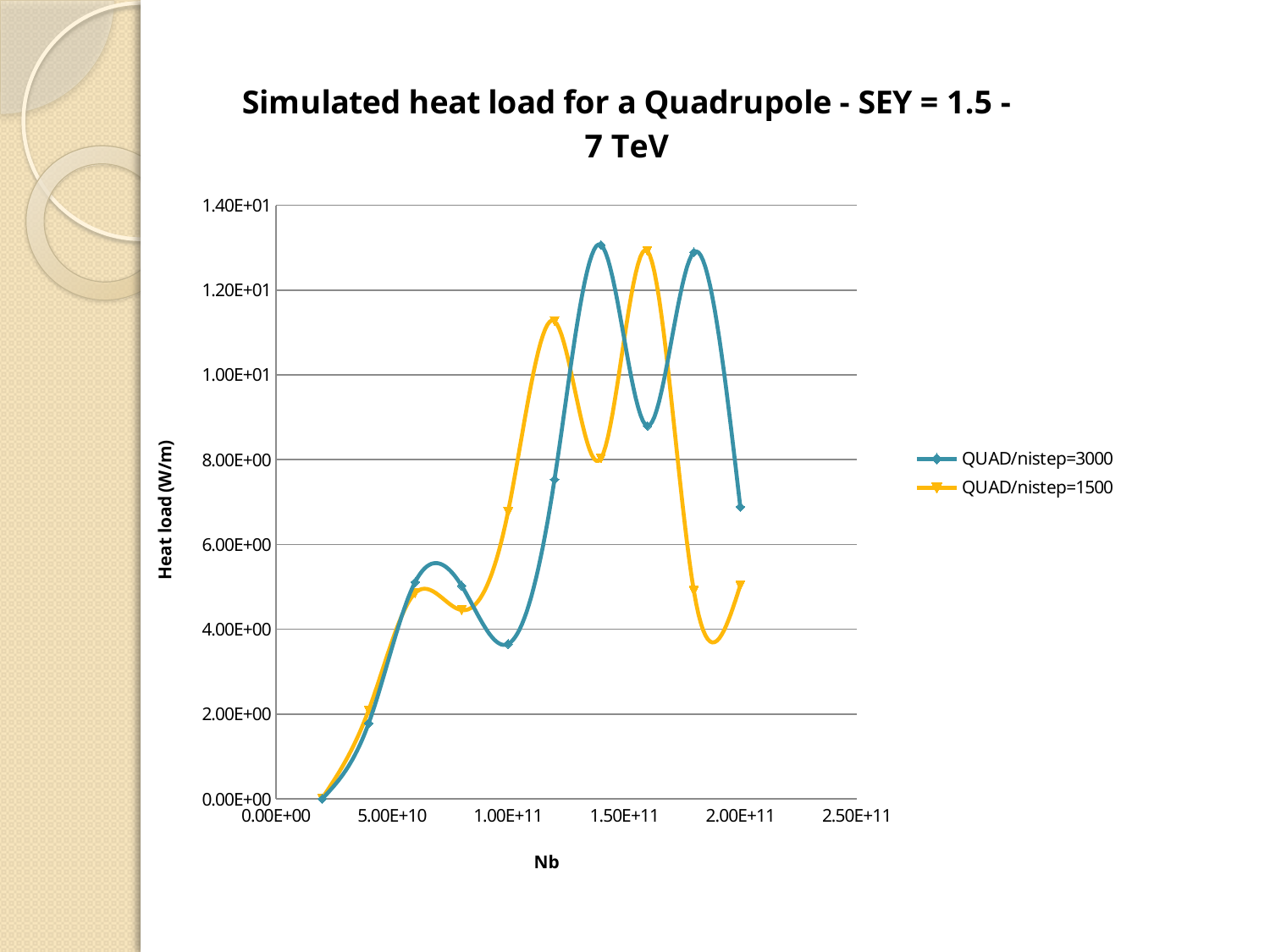
Is the value for QUAD/nistep=1500 at Nb = 1.20E+11 greater or less than 1.00E+01? greater Is the value for QUAD/nistep=3000 at Nb = 1.00E+11 greater or less than 4.00E+00? less How many data points are plotted for the QUAD/nistep=3000 series? 10 Is the value for QUAD/nistep=3000 at Nb = 1.40E+11 greater or less than 1.20E+01? greater Does the heat load for QUAD/nistep=3000 rise or fall between Nb = 1.80E+11 and Nb = 2.00E+11? fall At Nb = 1.20E+11, which series has the higher heat load, QUAD/nistep=3000 or QUAD/nistep=1500? QUAD/nistep=1500 What kind of chart is shown on the slide? Line chart At Nb = 1.40E+11, which series has the higher heat load, QUAD/nistep=3000 or QUAD/nistep=1500? QUAD/nistep=3000 What is the label of the vertical axis? Heat load (W/m) How many series does the legend list? 2 What is the title of the chart? Simulated heat load for a Quadrupole - SEY = 1.5 - 7 TeV